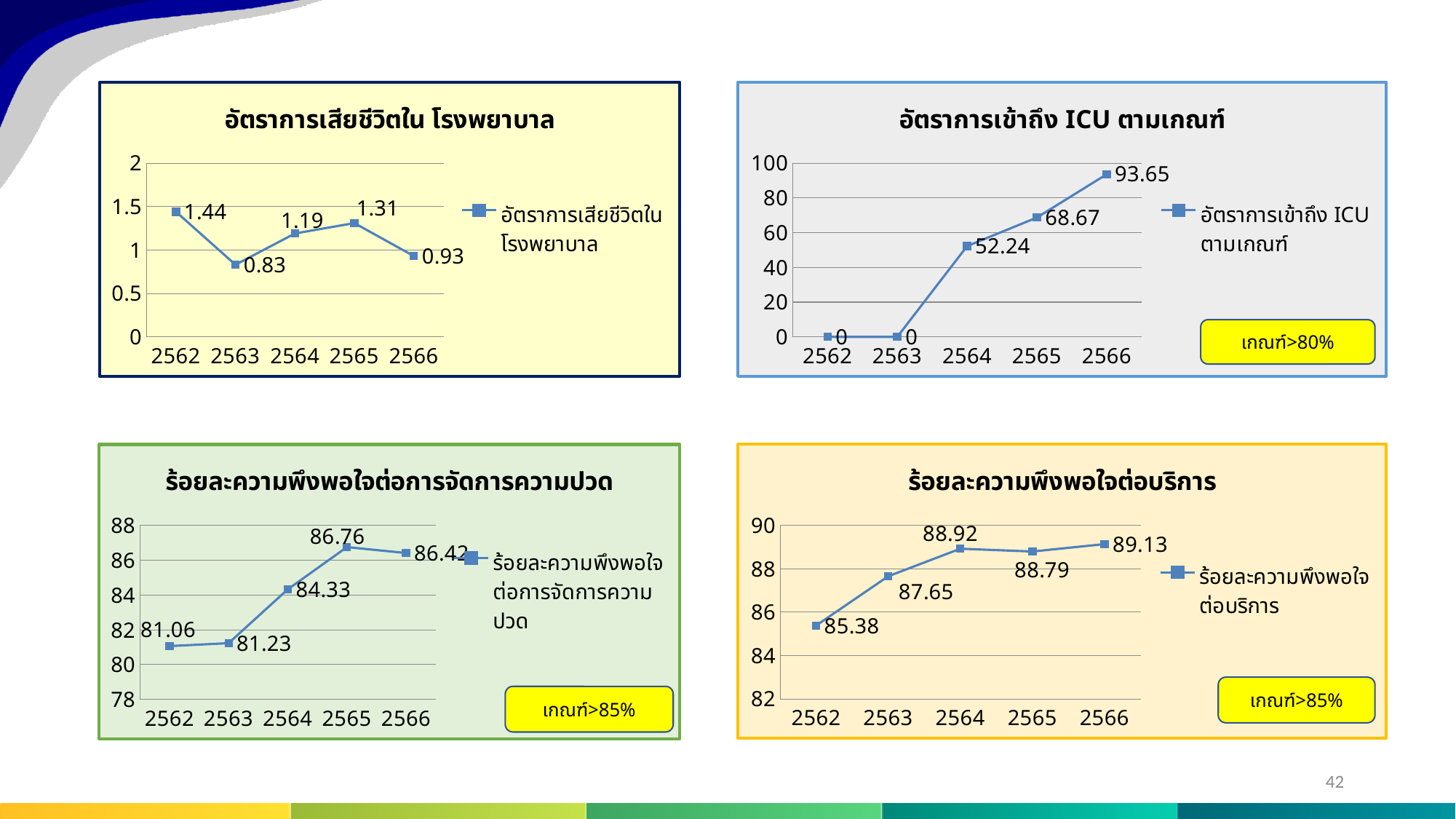
What kind of chart is the bottom-right chart (ร้อยละความพึงพอใจต่อบริการ)? Line chart In the top-left chart (อัตราการเสียชีวิตใน โรงพยาบาล), what is the value for 2563? 0.83 In the bottom-left chart (ร้อยละความพึงพอใจต่อการจัดการความปวด), which is larger, the value for 2565 or 2566? 2565 In the bottom-right chart (ร้อยละความพึงพอใจต่อบริการ), which year has the highest value? 2566 In the top-left chart (อัตราการเสียชีวิตใน โรงพยาบาล), which year has the highest value? 2562 In the top-right chart (อัตราการเข้าถึง ICU ตามเกณฑ์), what is the value for 2566? 93.65 In the bottom-left chart (ร้อยละความพึงพอใจต่อการจัดการความปวด), which year has the lowest value? 2562 What threshold is shown in the yellow box on the top-right chart (อัตราการเข้าถึง ICU ตามเกณฑ์)? เกณฑ์>80% In the bottom-left chart (ร้อยละความพึงพอใจต่อการจัดการความปวด), what is the value for 2564? 84.33 In the bottom-right chart (ร้อยละความพึงพอใจต่อบริการ), what is the value for 2562? 85.38 In the top-right chart (อัตราการเข้าถึง ICU ตามเกณฑ์), how many years are plotted on the x axis? 5 In the top-right chart (อัตราการเข้าถึง ICU ตามเกณฑ์), what is the difference between the values for 2566 and 2565? 24.98